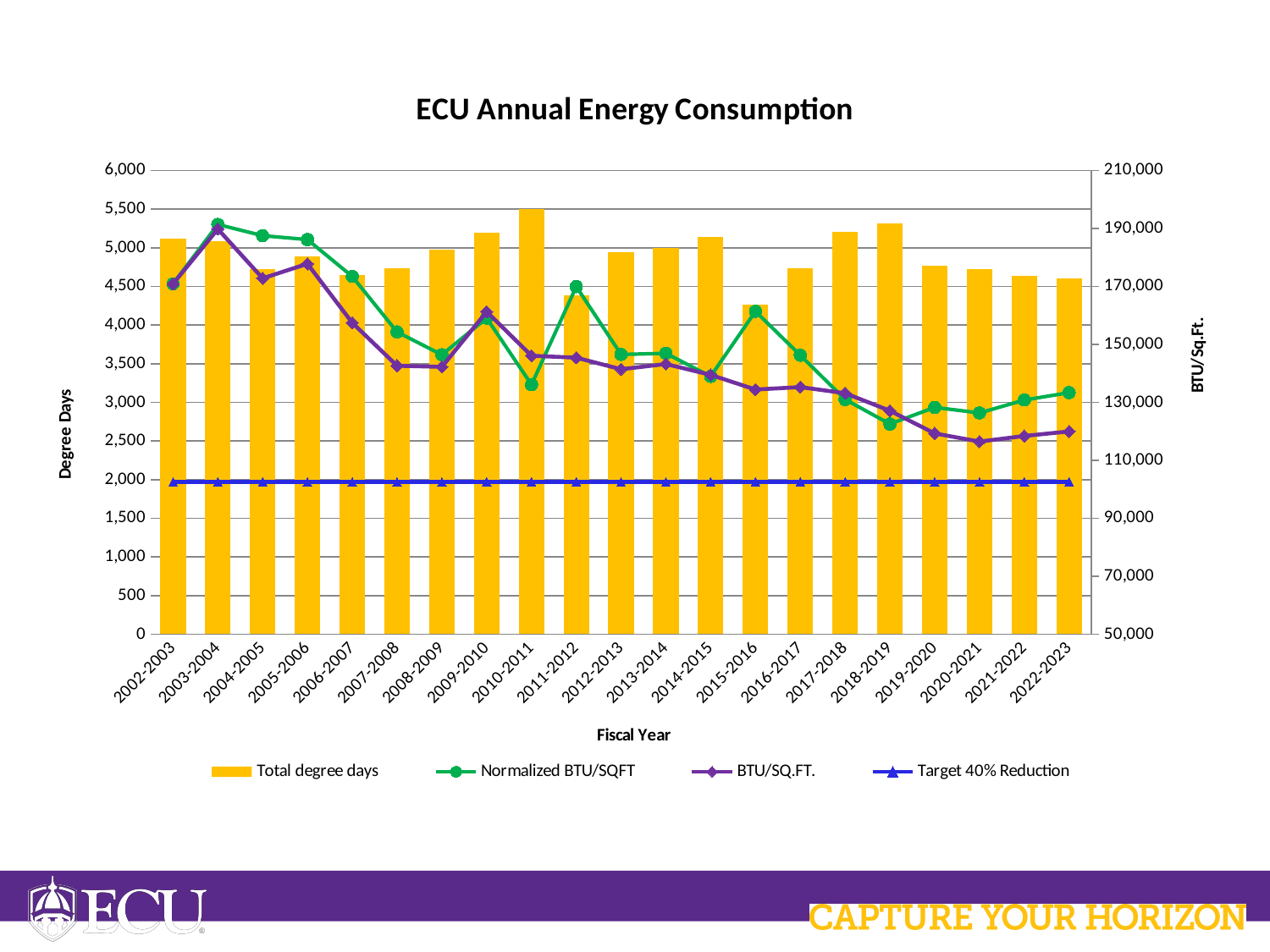
Which fiscal year has the lowest Total degree days bar? 2015-2016 How many fiscal years are shown on the x axis? 21 Does the BTU/SQ.FT. line generally rise or fall from 2003-2004 to 2022-2023? fall Which fiscal year has the highest Normalized BTU/SQFT value? 2003-2004 What is the title of the chart? ECU Annual Energy Consumption Is the BTU/SQ.FT. value for 2020-2021 greater or less than 130,000? less Is the Total degree days value for 2010-2011 greater or less than 5,000? greater Which fiscal year has the highest Total degree days bar? 2010-2011 How many series does the legend list? 4 Which fiscal year has the lowest BTU/SQ.FT. value? 2020-2021 What kind of chart is this? Combined bar and line chart Is the Total degree days value for 2015-2016 greater or less than 4,500? less